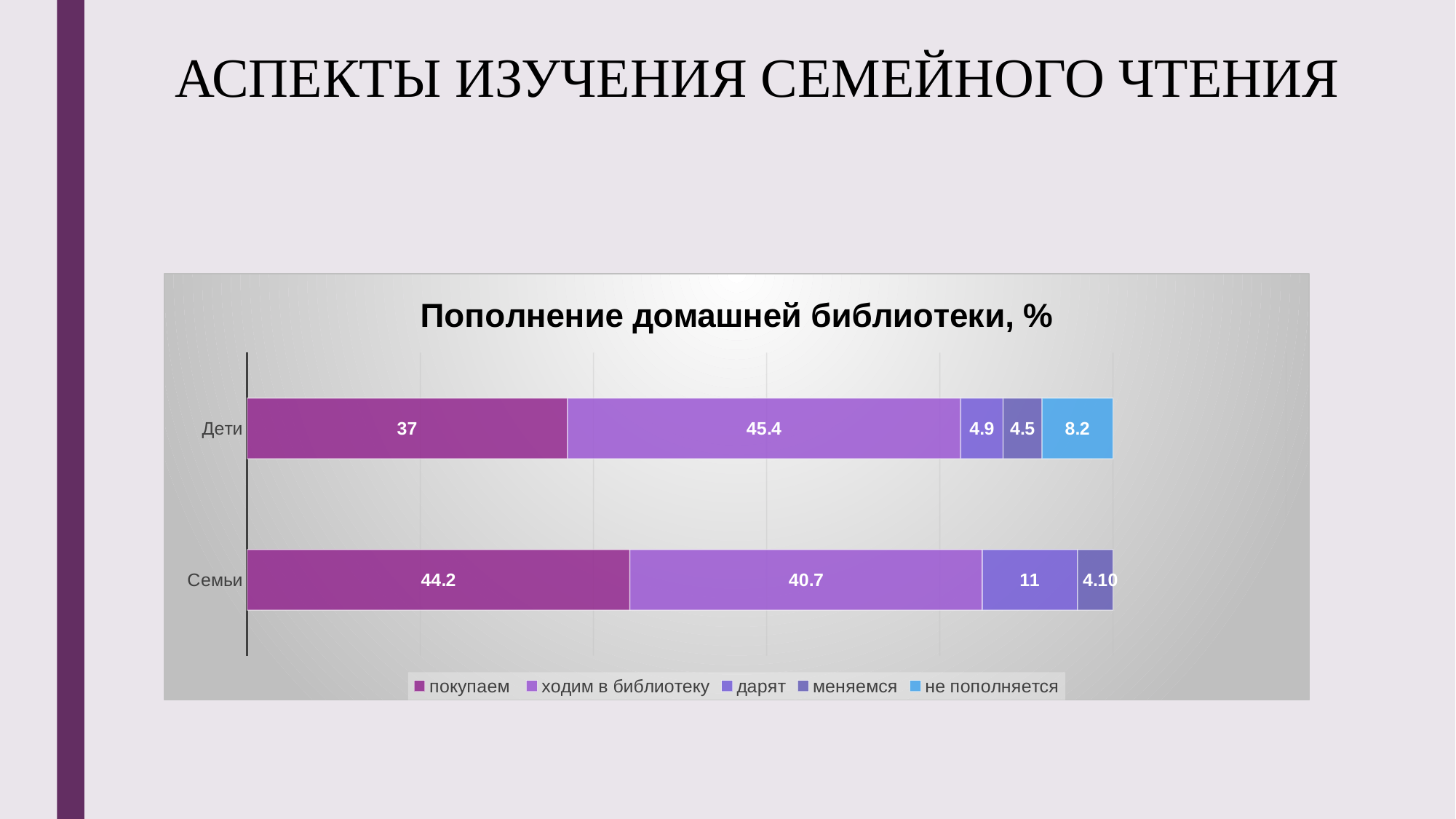
What kind of chart is shown? Stacked bar chart How many categories are shown on the vertical axis? 2 What is the value of "дарят" for Семьи? 11 What is the difference between the "покупаем" values for Семьи and Дети? 7.2 What is the value of "не пополняется" for Дети? 8.2 What is the value of "ходим в библиотеку" for Семьи? 40.7 What is the title of the chart? Пополнение домашней библиотеки, % What is the value of "меняемся" for Дети? 4.5 Which category has the larger value for "ходим в библиотеку", Дети or Семьи? Дети How many series does the legend list? 5 Which category has the larger value for "дарят", Дети or Семьи? Семьи What is the value of "покупаем" for Дети? 37